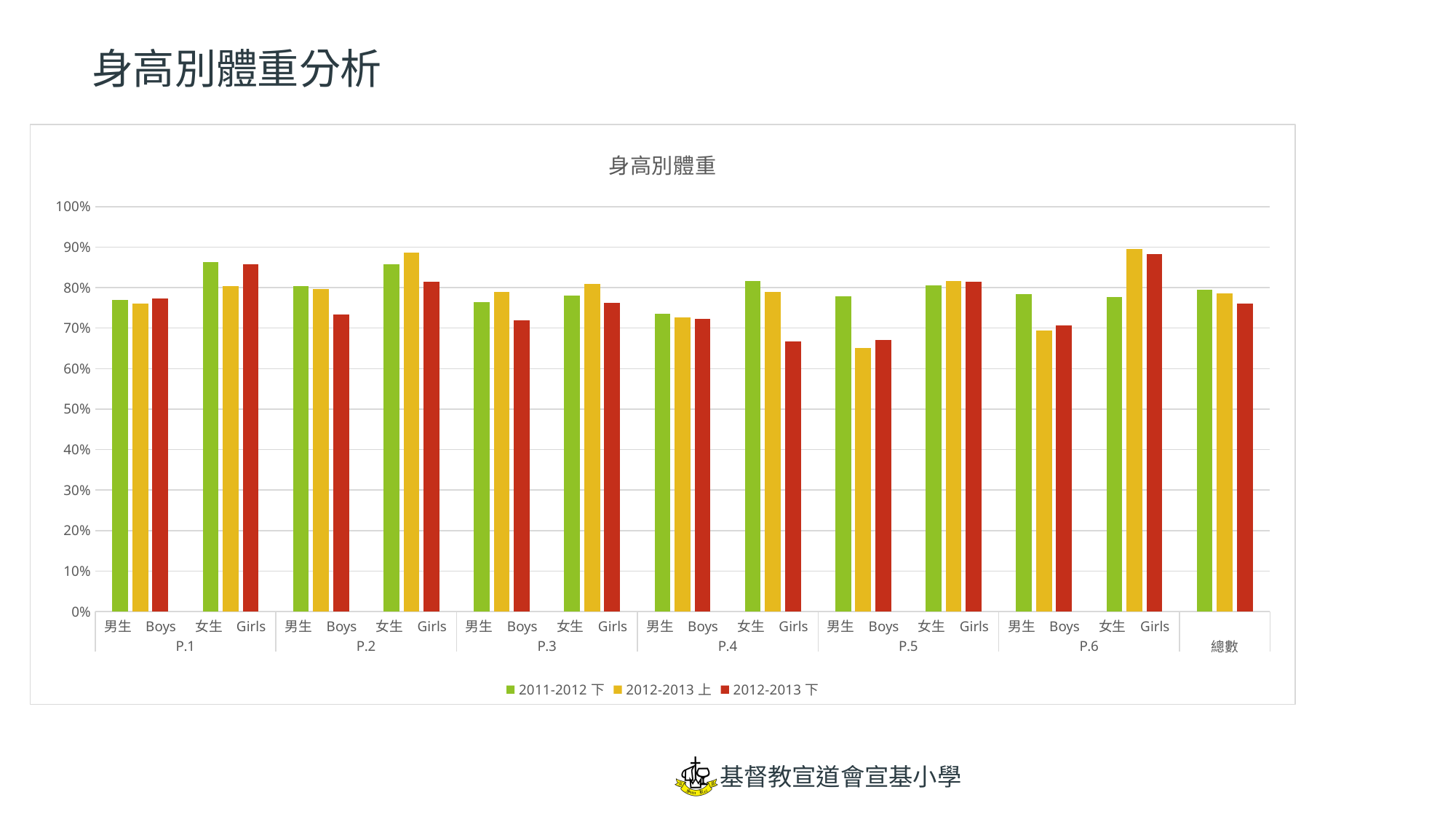
For P.4 Girls, which series has the larger value: 2011-2012 下 or 2012-2013 下? 2011-2012 下 Which series is shown in red in the legend? 2012-2013 下 Is the value for 總數 in the 2012-2013 下 series greater or less than 70%? greater In the 2012-2013 上 series, which category has the lowest value? P.5 Boys Is the value for P.5 Boys in the 2012-2013 上 series greater or less than 70%? less What kind of chart is shown on the slide? bar chart How many category groups are shown along the x axis? 13 How many series does the legend list? 3 For P.5 Boys, which series has the larger value: 2011-2012 下 or 2012-2013 上? 2011-2012 下 Is the value for P.4 Girls in the 2012-2013 下 series greater or less than 70%? less What is the title of the chart? 身高別體重